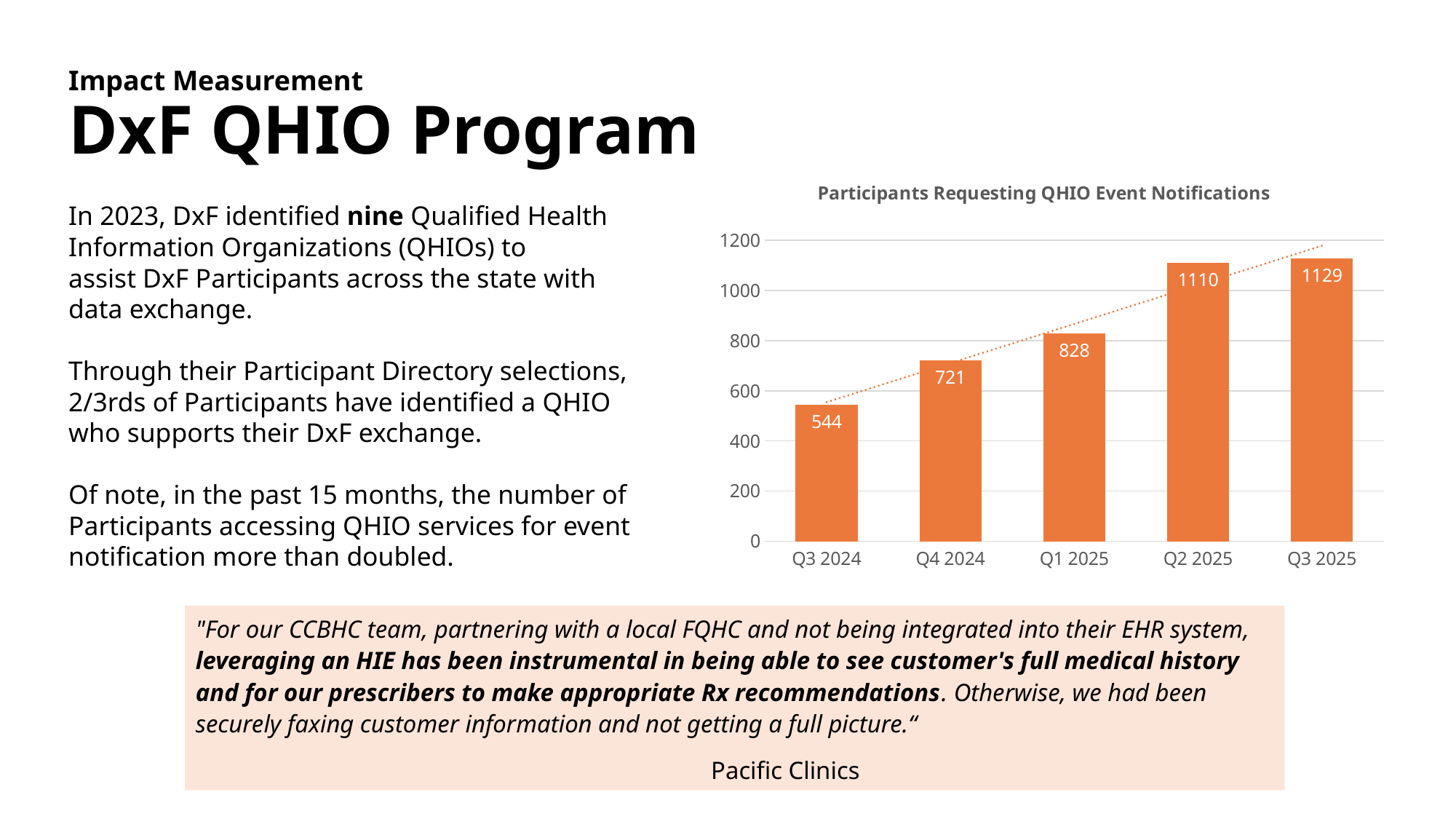
Is the value for Q4 2024 greater or less than 600? greater What kind of chart is shown on the slide? Bar chart How many quarters are shown on the x axis of the chart? 5 What is the value for Q2 2025 in the chart? 1110 Which is larger, the value for Q4 2024 or the value for Q1 2025? Q1 2025 Which quarter has the highest number of participants requesting QHIO event notifications? Q3 2025 What is the difference between the values for Q3 2025 and Q3 2024? 585 What is the difference between the values for Q1 2025 and Q4 2024? 107 Do the values rise or fall from Q3 2024 to Q3 2025? Rise What is the value for Q1 2025 in the chart? 828 Which quarter has the lowest number of participants requesting QHIO event notifications? Q3 2024 What is the value for Q3 2024 in the Participants Requesting QHIO Event Notifications chart? 544